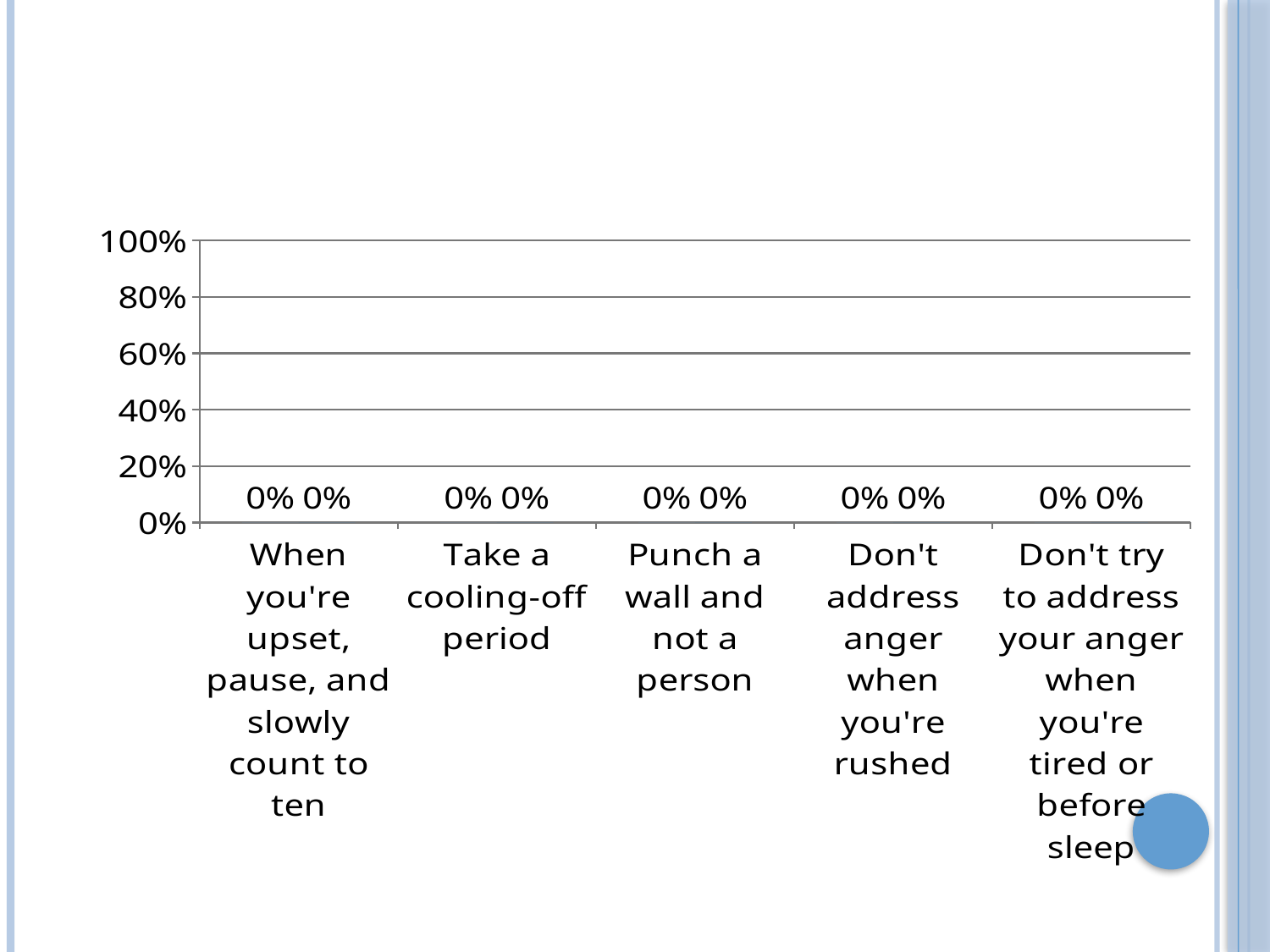
Is the value for "When you're upset, pause, and slowly count to ten" greater or less than 20%? less What value is shown for "Don't address anger when you're rushed"? 0% What value is shown for the category "Take a cooling-off period"? 0% What value is shown for the category "Punch a wall and not a person"? 0% Do any of the categories on the chart have a value above 0%? No What is the highest value shown on the y axis of the chart? 100% What is the difference between the values for "Take a cooling-off period" and "Punch a wall and not a person"? 0% What is the interval between the tick marks on the y axis? 20% How many categories are shown along the x axis of the chart? 5 What is the label of the last category on the x axis? Don't try to address your anger when you're tired or before sleep How many data labels are printed above each category on the chart? 2